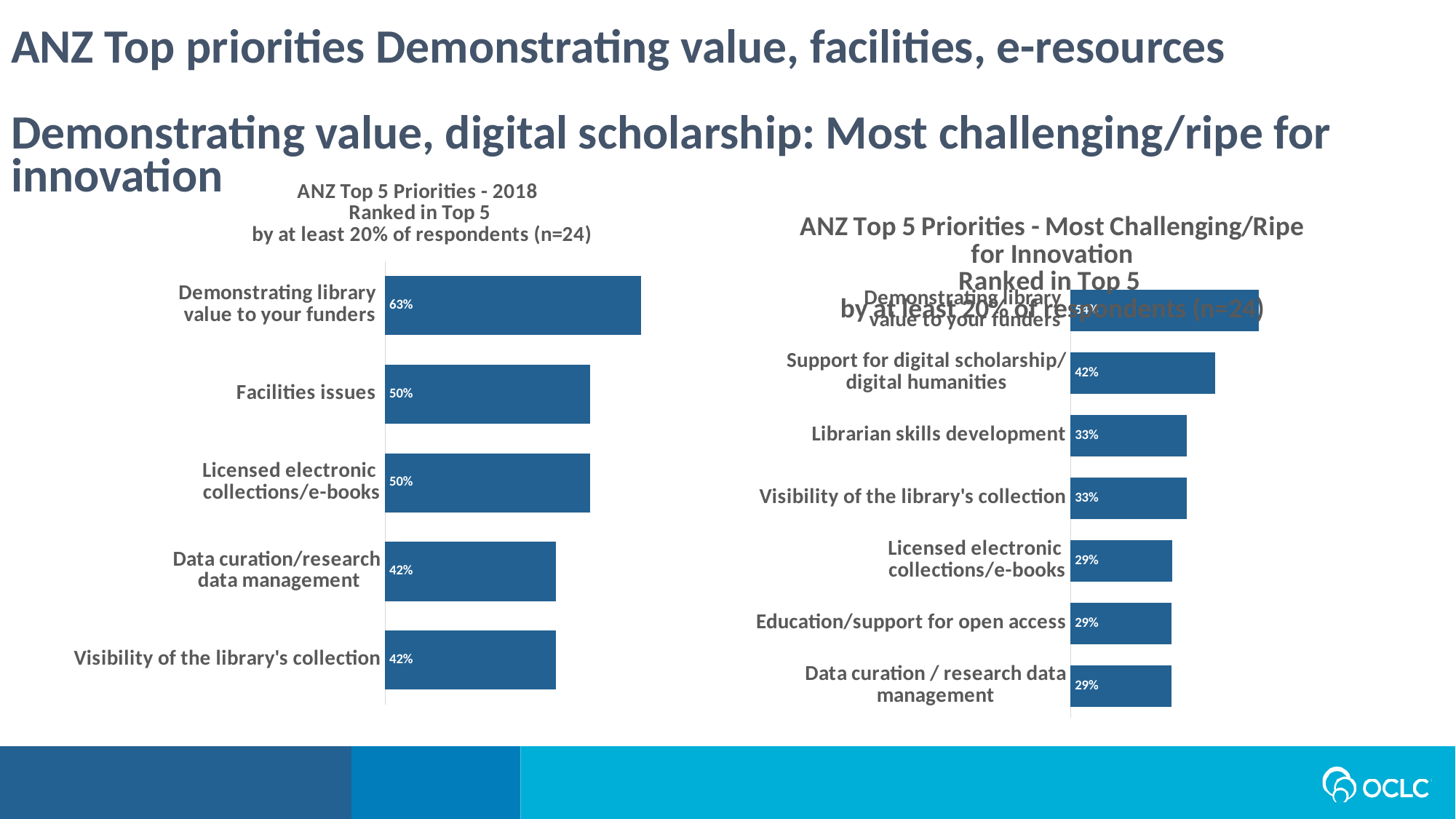
How many categories are shown in the left chart (ANZ Top 5 Priorities - 2018)? 5 In the left chart (ANZ Top 5 Priorities - 2018), what is the value for 'Data curation/research data management'? 42% In the left chart (ANZ Top 5 Priorities - 2018), what is the difference between 'Demonstrating library value to your funders' and 'Facilities issues'? 13% How many categories are shown in the right chart (Most Challenging/Ripe for Innovation)? 7 In the right chart (Most Challenging/Ripe for Innovation), what is the value for 'Education/support for open access'? 29% What type of chart is used on the left side of the slide? Bar chart In the right chart (Most Challenging/Ripe for Innovation), which category has the longest bar? Demonstrating library value to your funders In the right chart (Most Challenging/Ripe for Innovation), what is the value for 'Librarian skills development'? 33% In the right chart (Most Challenging/Ripe for Innovation), what is the value for 'Support for digital scholarship/digital humanities'? 42% In the left chart (ANZ Top 5 Priorities - 2018), what percentage ranked 'Demonstrating library value to your funders' in their top 5? 63% In the left chart (ANZ Top 5 Priorities - 2018), what is the value for 'Facilities issues'? 50% In the left chart (ANZ Top 5 Priorities - 2018), which category has the highest value? Demonstrating library value to your funders